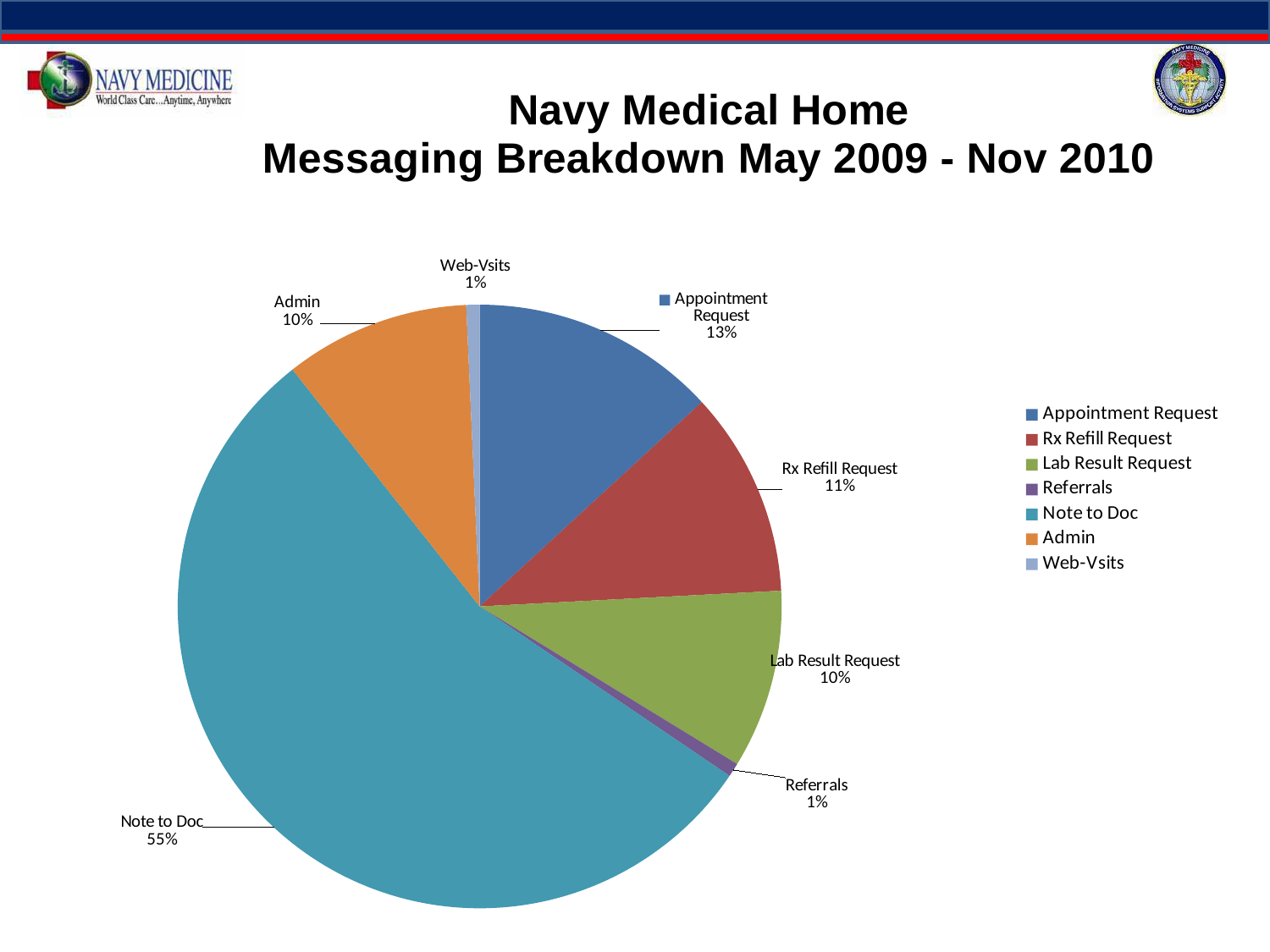
What share of messages is Note to Doc? 55% Which is larger, the Appointment Request share or the Rx Refill Request share? Appointment Request What colour is the Note to Doc slice? Teal What percentage of messages are Lab Result Requests? 10% What kind of chart is shown on the slide? Pie chart What percentage of messages are Admin? 10% How many categories does the legend list? 7 What percentage of messages are Appointment Requests? 13% What percentage of messages are Rx Refill Requests? 11% What is the combined share of Referrals and Web-Vsits? 2% Which category has the largest share of messages? Note to Doc What is the difference in percentage points between Note to Doc and Appointment Request? 42